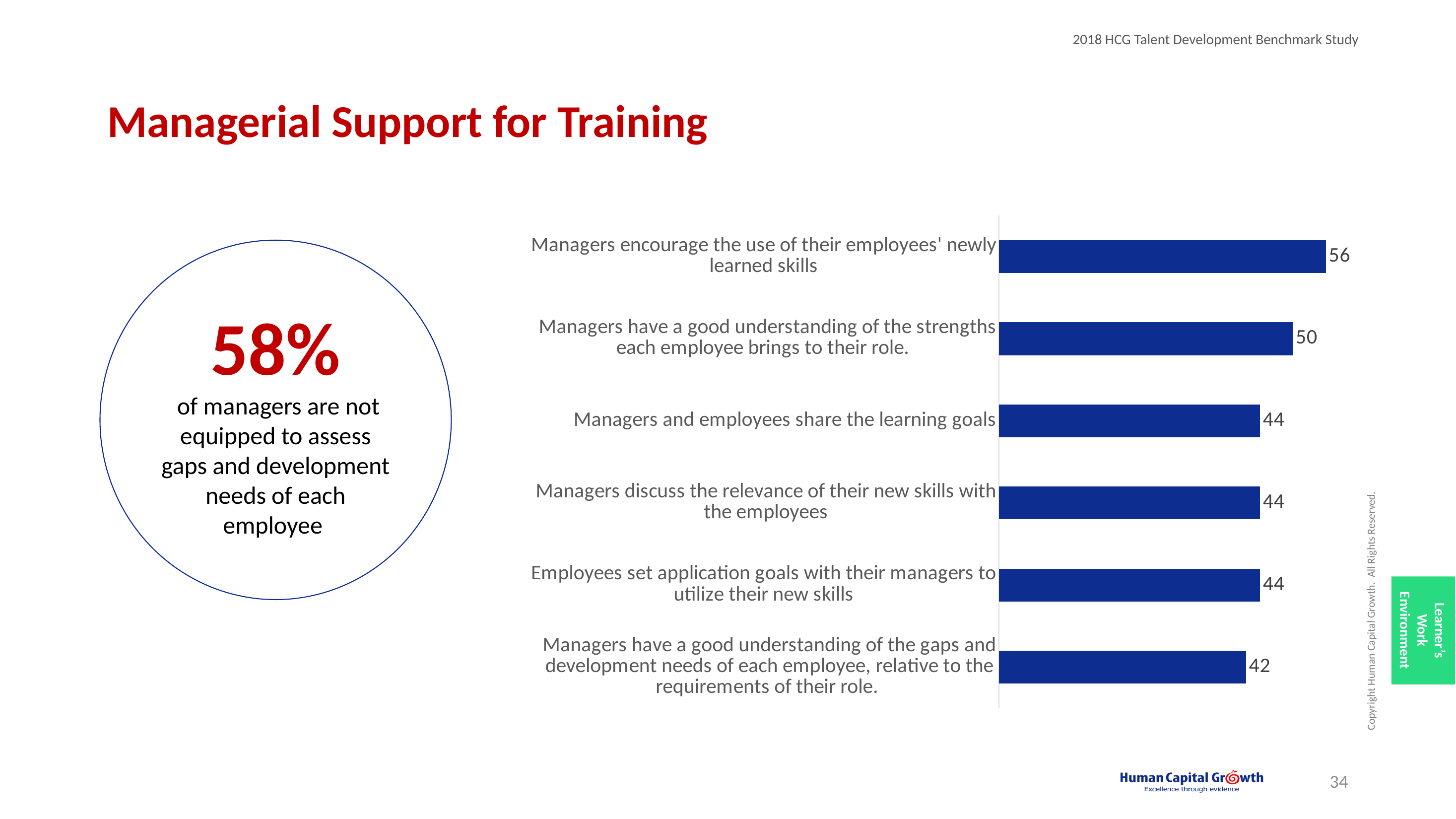
What is the value for "Managers and employees share the learning goals"? 44 Which category has the lowest value? Managers have a good understanding of the gaps and development needs of each employee, relative to the requirements of their role. What is the value for "Managers have a good understanding of the strengths each employee brings to their role."? 50 Which is larger: the value for "Managers and employees share the learning goals" or the value for "Managers have a good understanding of the gaps and development needs of each employee, relative to the requirements of their role."? Managers and employees share the learning goals How many categories are shown in the chart? 6 Which category has the highest value? Managers encourage the use of their employees' newly learned skills What is the value for "Managers have a good understanding of the gaps and development needs of each employee, relative to the requirements of their role."? 42 What is the difference between the value for "Managers encourage the use of their employees' newly learned skills" and the value for "Managers have a good understanding of the strengths each employee brings to their role."? 6 What is the value for "Managers encourage the use of their employees' newly learned skills"? 56 How many categories in the chart have a value of 44? 3 What kind of chart is shown on the slide? Bar chart What is the difference between the highest and lowest values in the chart? 14